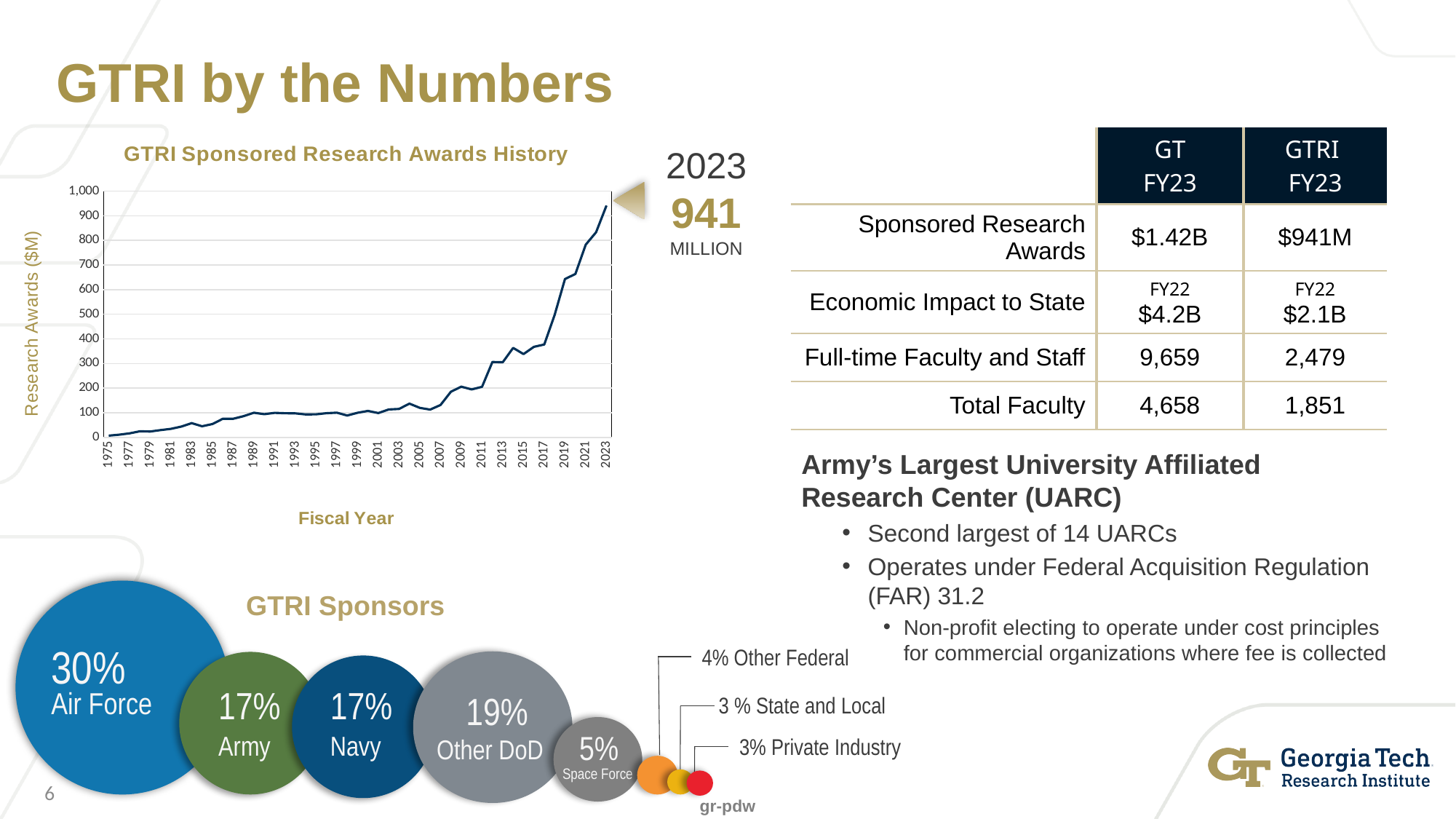
What kind of chart is the GTRI Sponsored Research Awards History chart? line chart What is the label of the y axis in the GTRI Sponsored Research Awards History chart? Research Awards ($M) In the GTRI Sponsored Research Awards History chart, do research awards generally rise or fall from 1975 to 2023? rise In the GTRI Sponsored Research Awards History chart, is the value for 2005 greater or less than 200? less In the GTRI Sponsored Research Awards History chart, which year has the highest research awards? 2023 In the GTRI Sponsors chart, how many sponsor categories are shown? 8 In the GTRI Sponsored Research Awards History chart, what is the value of research awards for 2023? 941 million In the GTRI Sponsors chart, which is larger, Other DoD or Army? Other DoD In the GTRI Sponsors chart, which sponsor has the largest share? Air Force In the GTRI Sponsored Research Awards History chart, is the value for 2019 greater or less than 500? greater In the GTRI Sponsors chart, what percentage of sponsorship comes from the Air Force? 30% In the GTRI Sponsors chart, what is the difference in percentage points between Air Force and Other DoD? 11